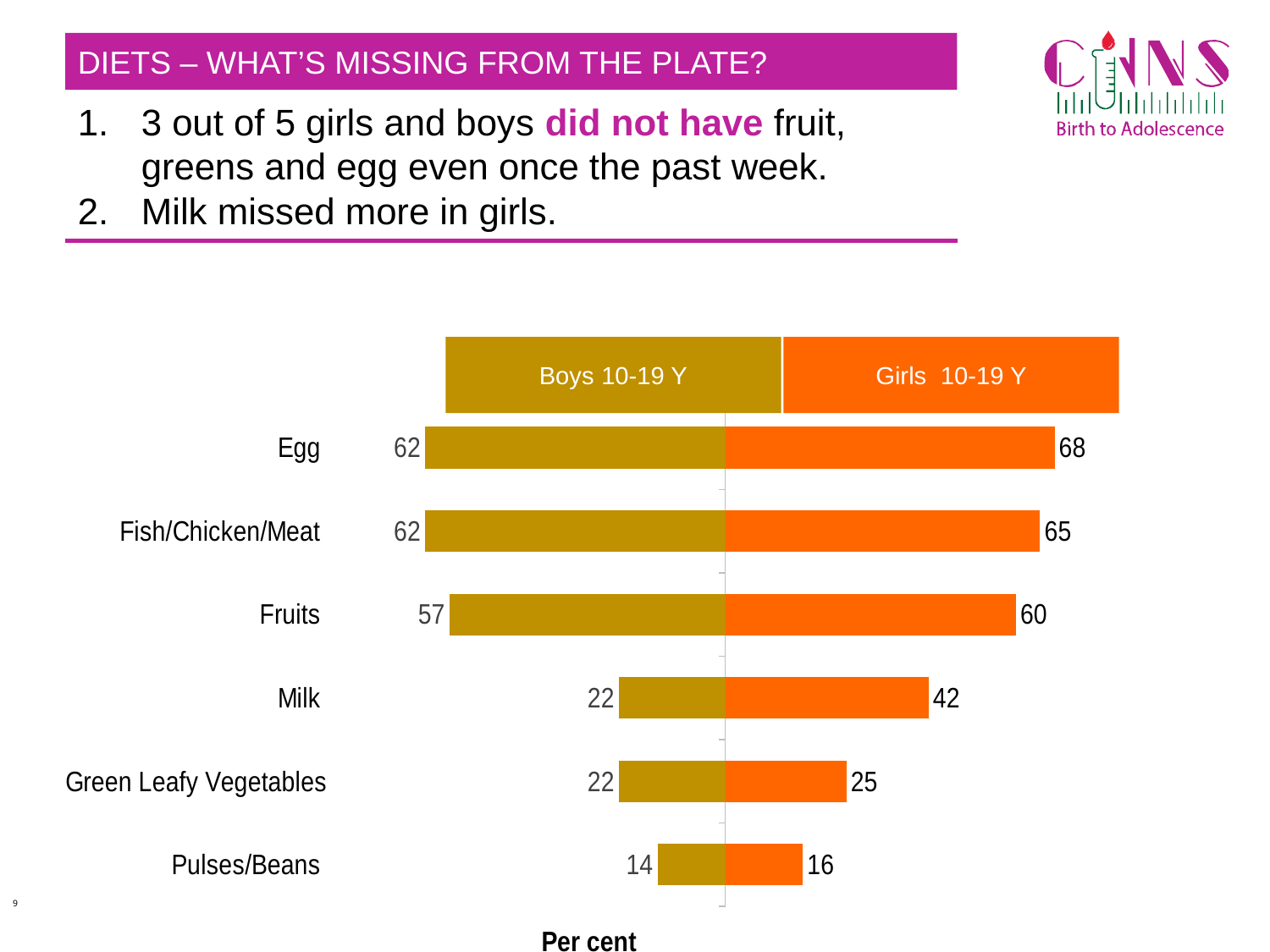
What unit is labelled on the axis of the chart? Per cent What is the value for Boys 10-19 Y for Fruits? 57 How many food categories are shown in the chart? 6 What kind of chart is shown on the slide? Bar chart Which category has the lowest value for Boys 10-19 Y? Pulses/Beans What is the difference between the Girls 10-19 Y and Boys 10-19 Y values for Egg? 6 What is the value for Girls 10-19 Y for Pulses/Beans? 16 What is the value for Girls 10-19 Y for Milk? 42 What is the difference between the Girls 10-19 Y and Boys 10-19 Y values for Milk? 20 Which is larger for Green Leafy Vegetables: the Boys 10-19 Y value or the Girls 10-19 Y value? Girls 10-19 Y Which category has the highest value for Girls 10-19 Y? Egg How many series does the chart show? 2